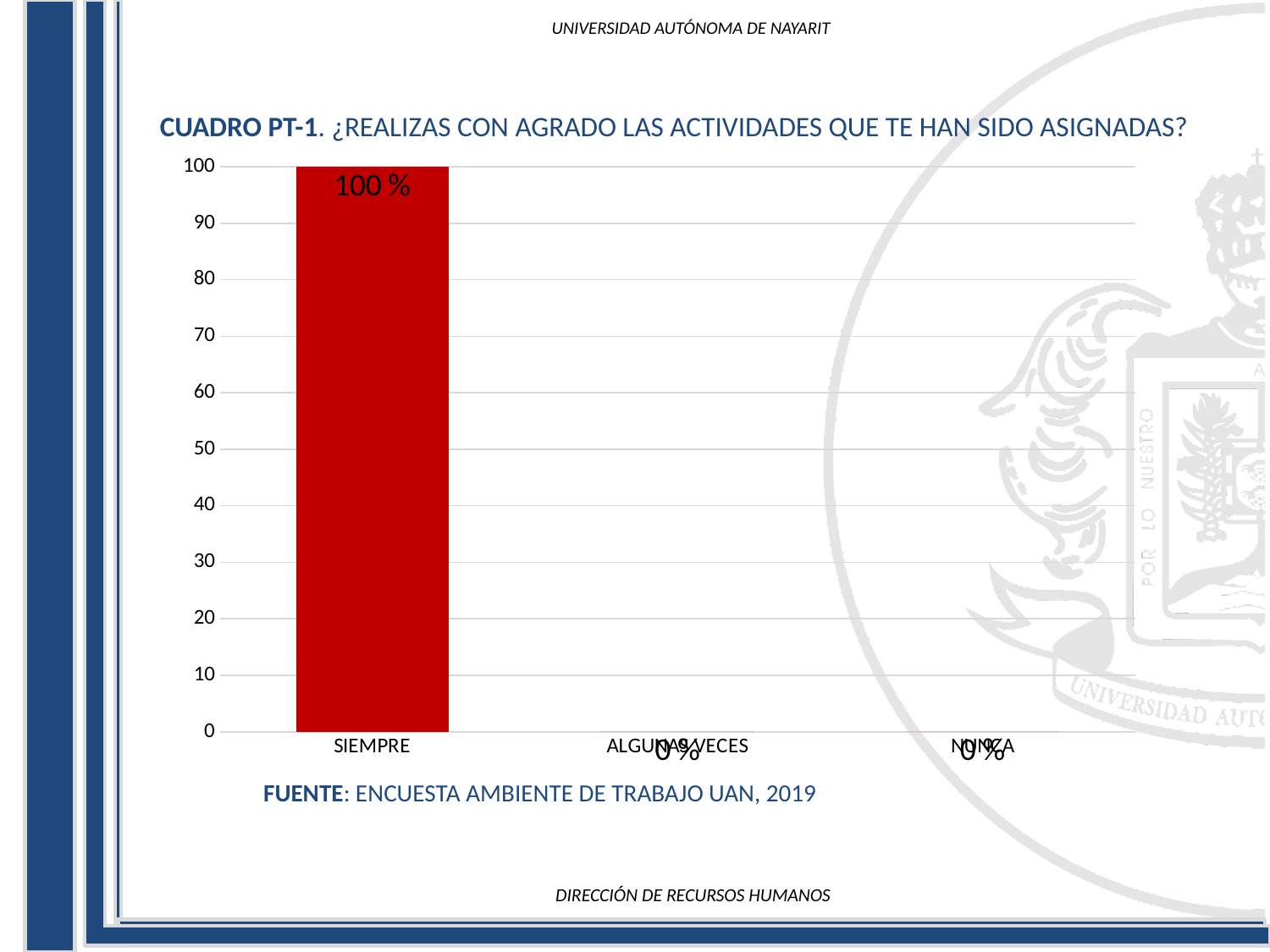
What colour is the bar for SIEMPRE? red How many categories are shown on the x axis? 3 Which is larger, the value for SIEMPRE or the value for ALGUNAS VECES? SIEMPRE What is the value for SIEMPRE? 100 % Do the values rise or fall from SIEMPRE to NUNCA along the x axis? fall What is the difference between the values for SIEMPRE and NUNCA? 100 % Is the value for SIEMPRE greater or less than 50? greater What kind of chart is shown on the slide? bar chart What is the value for ALGUNAS VECES? 0 % What is the source cited below the chart? ENCUESTA AMBIENTE DE TRABAJO UAN, 2019 What is the value for NUNCA? 0 % Which category has the highest value? SIEMPRE